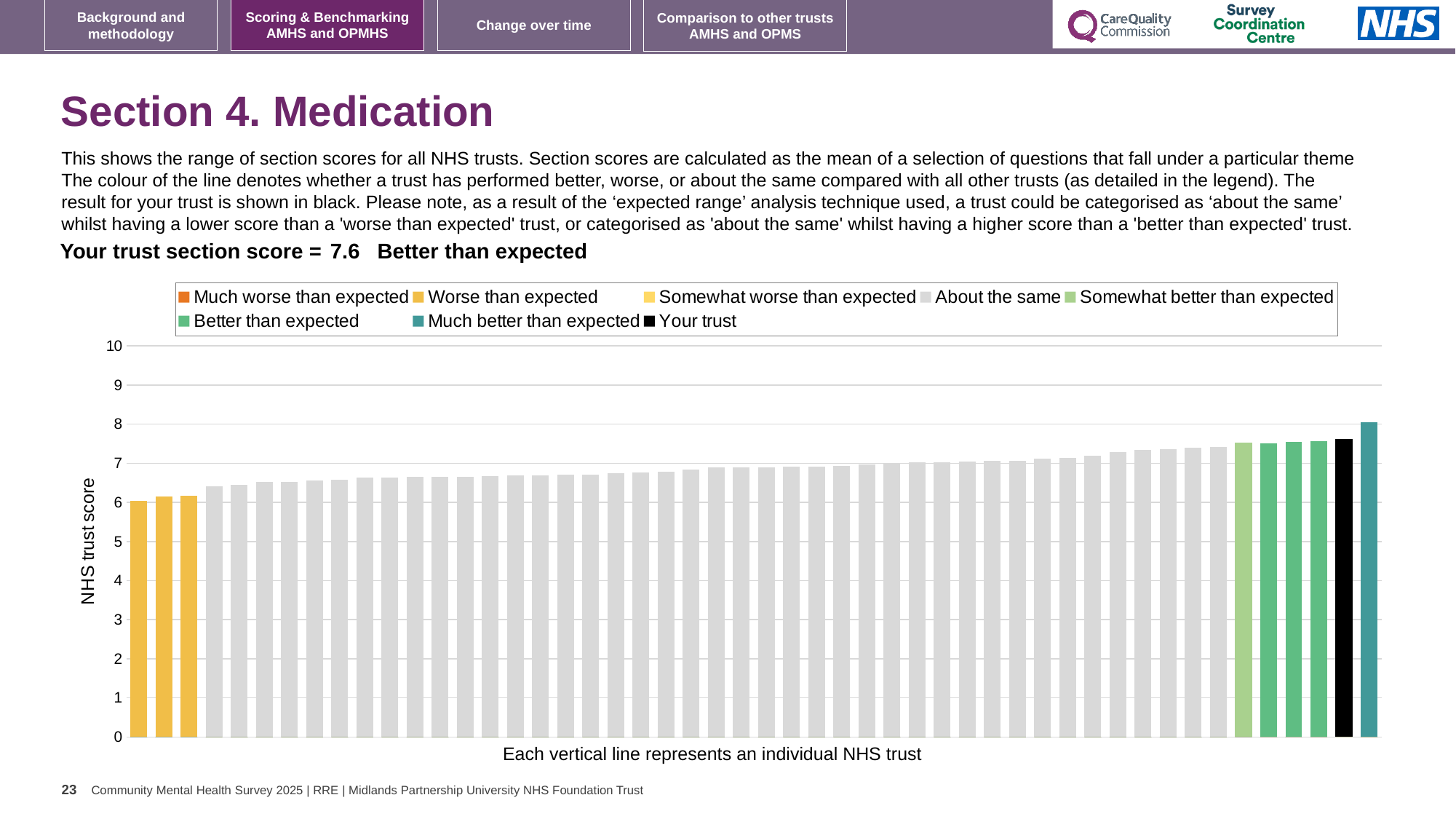
What is the label on the x axis? Each vertical line represents an individual NHS trust What is the label on the y axis? NHS trust score Which legend category does the highest bar belong to? Much better than expected Which is larger, the value for your trust (black bar) or the rightmost bar? the rightmost bar What kind of chart is shown on the slide? bar chart Is the value of the lowest bar greater or less than 7? less Is the value for your trust greater or less than 7? greater How many bars are coloured as 'Worse than expected'? 3 Is the value of the lowest bar greater or less than 5? greater What is the section score for your trust? 7.6 How many entries does the chart legend list? 8 Do the bar values rise or fall from left to right along the x axis? rise